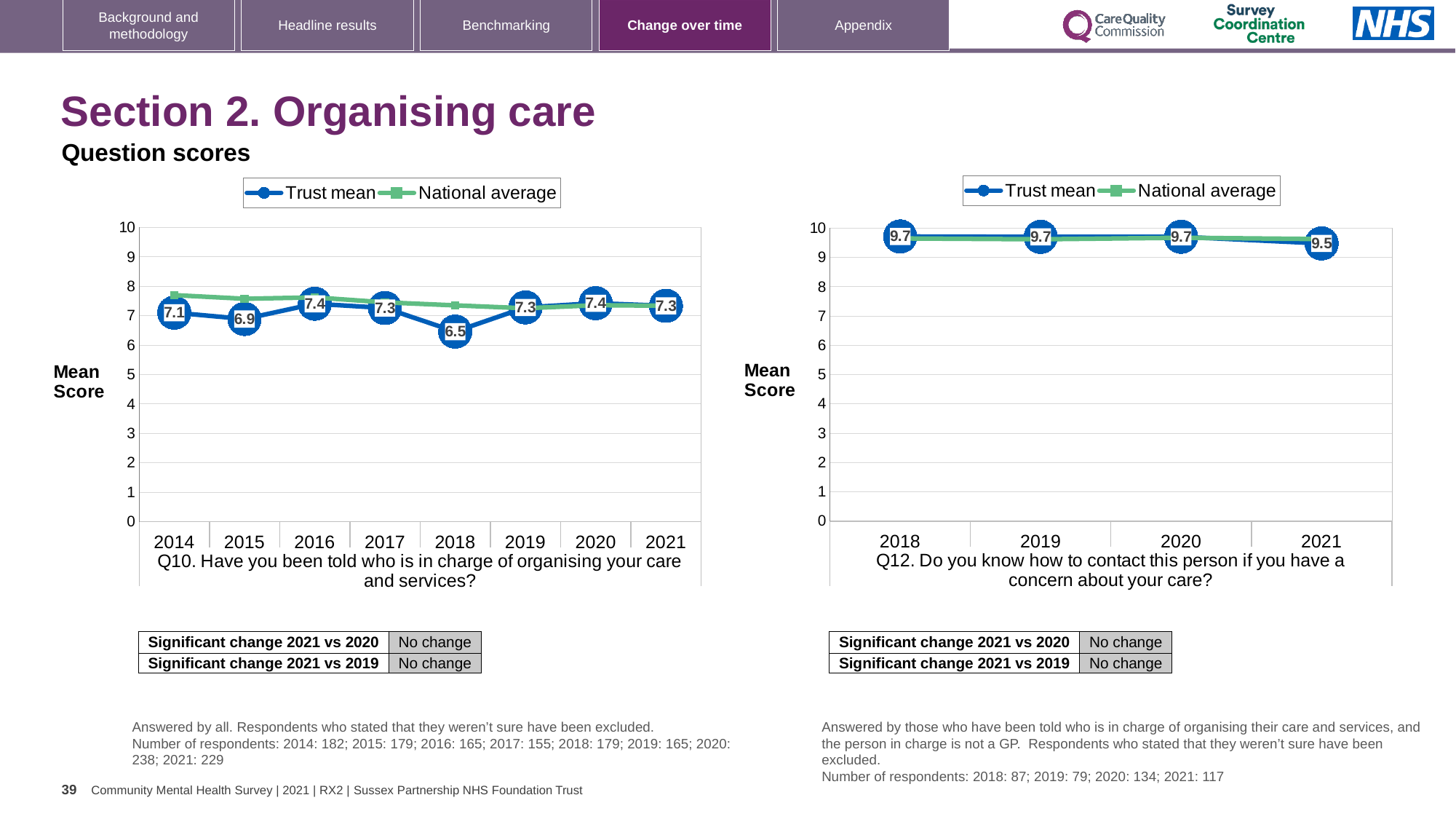
On the Q10 chart (left), what is the Trust mean for 2018? 6.5 On the Q10 chart (left), what is the Trust mean for 2014? 7.1 On the Q12 chart (right), what is the Trust mean for 2021? 9.5 On the Q12 chart (right), how many series does the legend list? 2 On the Q12 chart (right), does the Trust mean rise or fall from 2020 to 2021? Fall On the Q10 chart (left), is the Trust mean higher in 2015 or in 2016? 2016 On the Q10 chart (left), is the National average for 2014 greater or less than 7? greater On the Q12 chart (right), what is the difference between the Trust mean in 2020 and in 2021? 0.2 On the Q10 chart (left), how many years are plotted on the x axis? 8 On the Q10 chart (left), which year has the lowest Trust mean? 2018 On the Q10 chart (left), what is the difference between the Trust mean in 2016 and in 2018? 0.9 What kind of chart is the Q12 chart (right)? Line chart